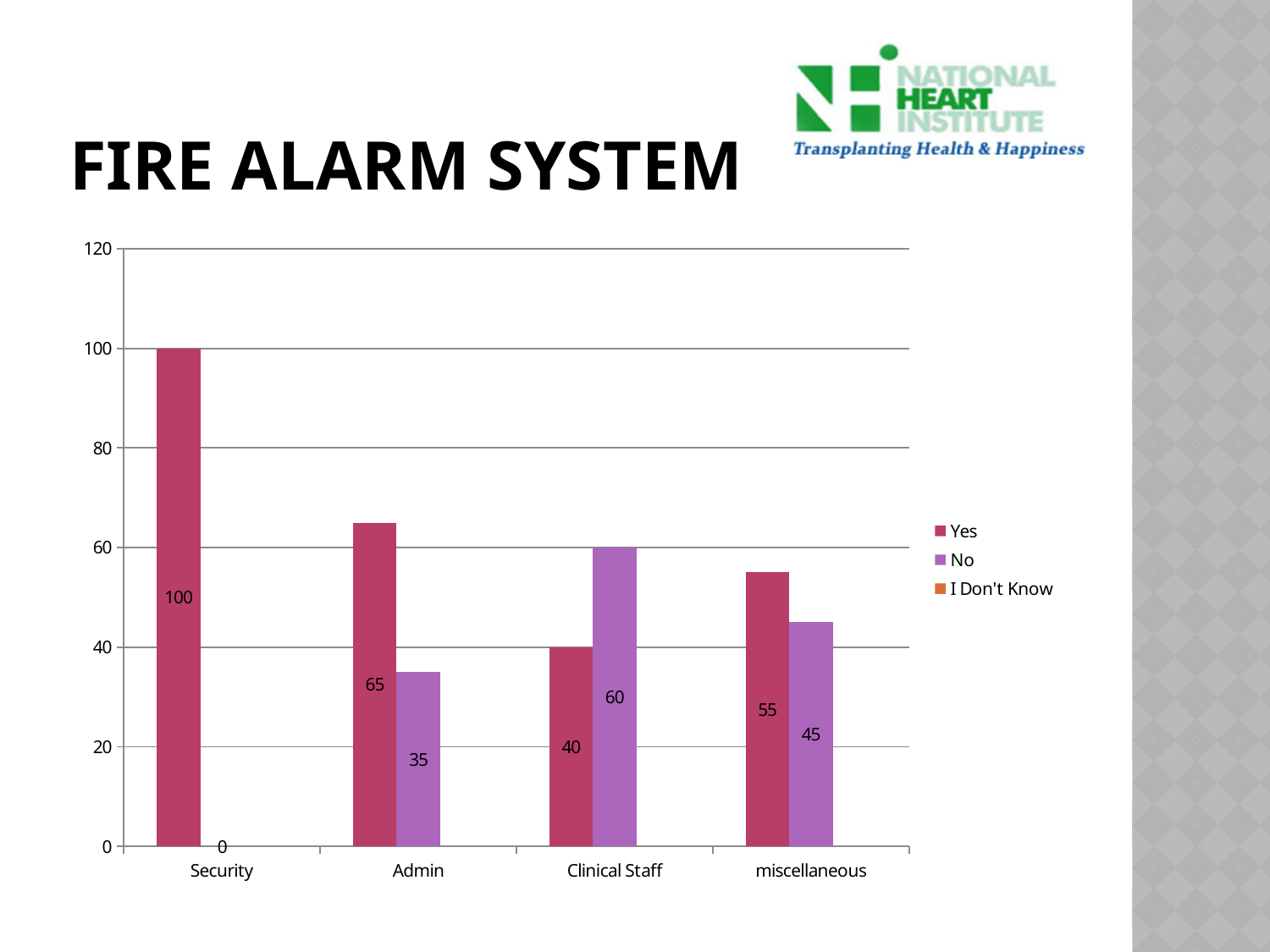
What is the No value for Clinical Staff? 60 Which category has the highest Yes value? Security Which category has the lowest Yes value? Clinical Staff How many series does the legend list? 3 What is the Yes value for miscellaneous? 55 How many categories are shown on the x axis? 4 Is the Yes value for Admin greater or less than 60? greater What kind of chart is shown on the slide? bar chart What is the No value for Admin? 35 What is the difference between the Yes and No values for Admin? 30 What is the Yes value for Security? 100 For Clinical Staff, which is larger, the Yes value or the No value? No